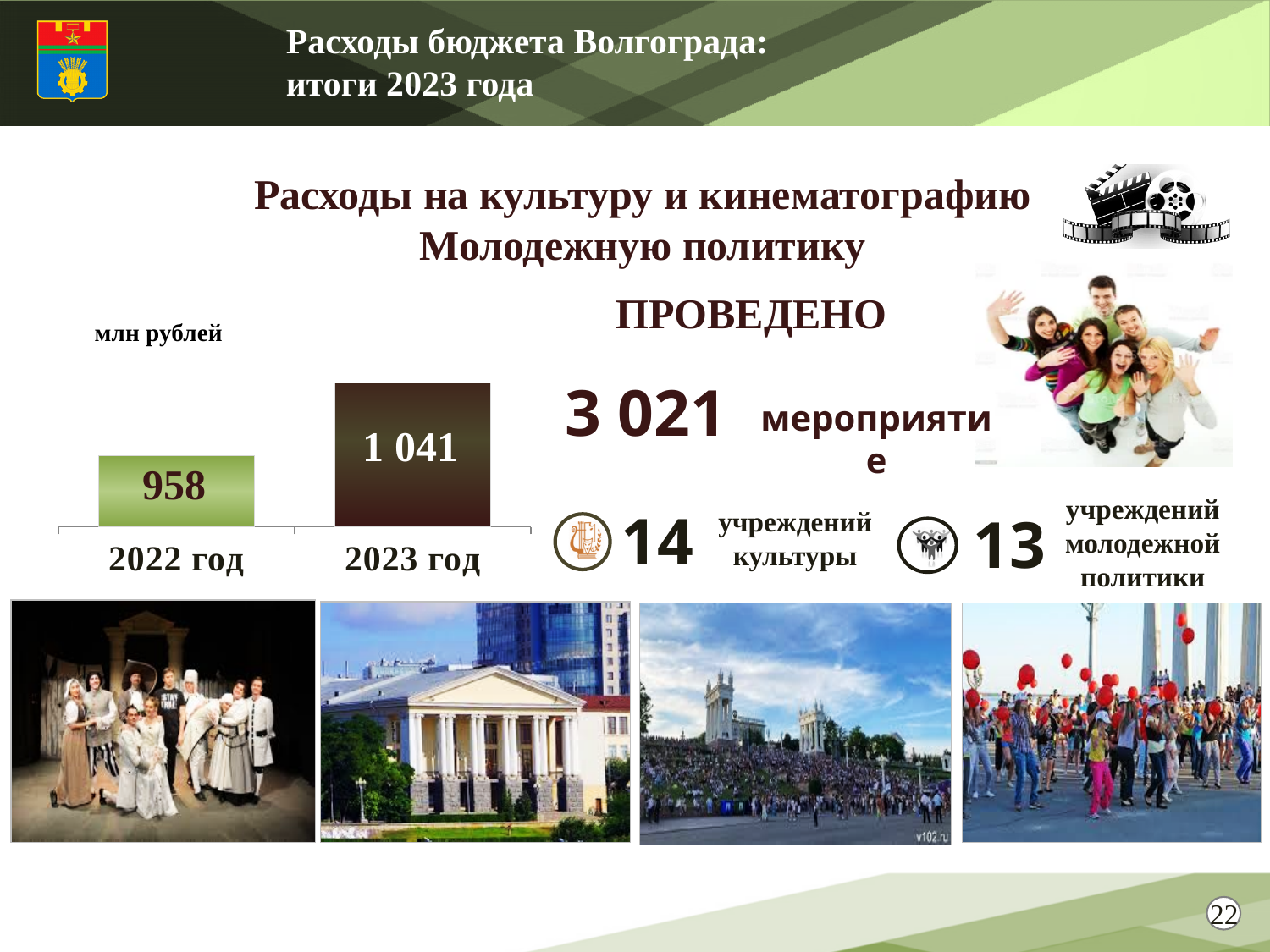
What is the value for 2022 год in the bar chart? 958 What kind of chart is shown on the slide? bar chart What is the value for 2023 год in the bar chart? 1 041 What colour is the bar for 2022 год? green Is the value for 2023 год larger or smaller than the value for 2022 год? larger What unit is indicated for the values in the bar chart? млн рублей Which year has the lower value in the bar chart? 2022 год How many bars are shown in the bar chart? 2 Do the values rise or fall from 2022 год to 2023 год? rise Which year has the higher value in the bar chart? 2023 год By how much does the value for 2023 год exceed the value for 2022 год? 83